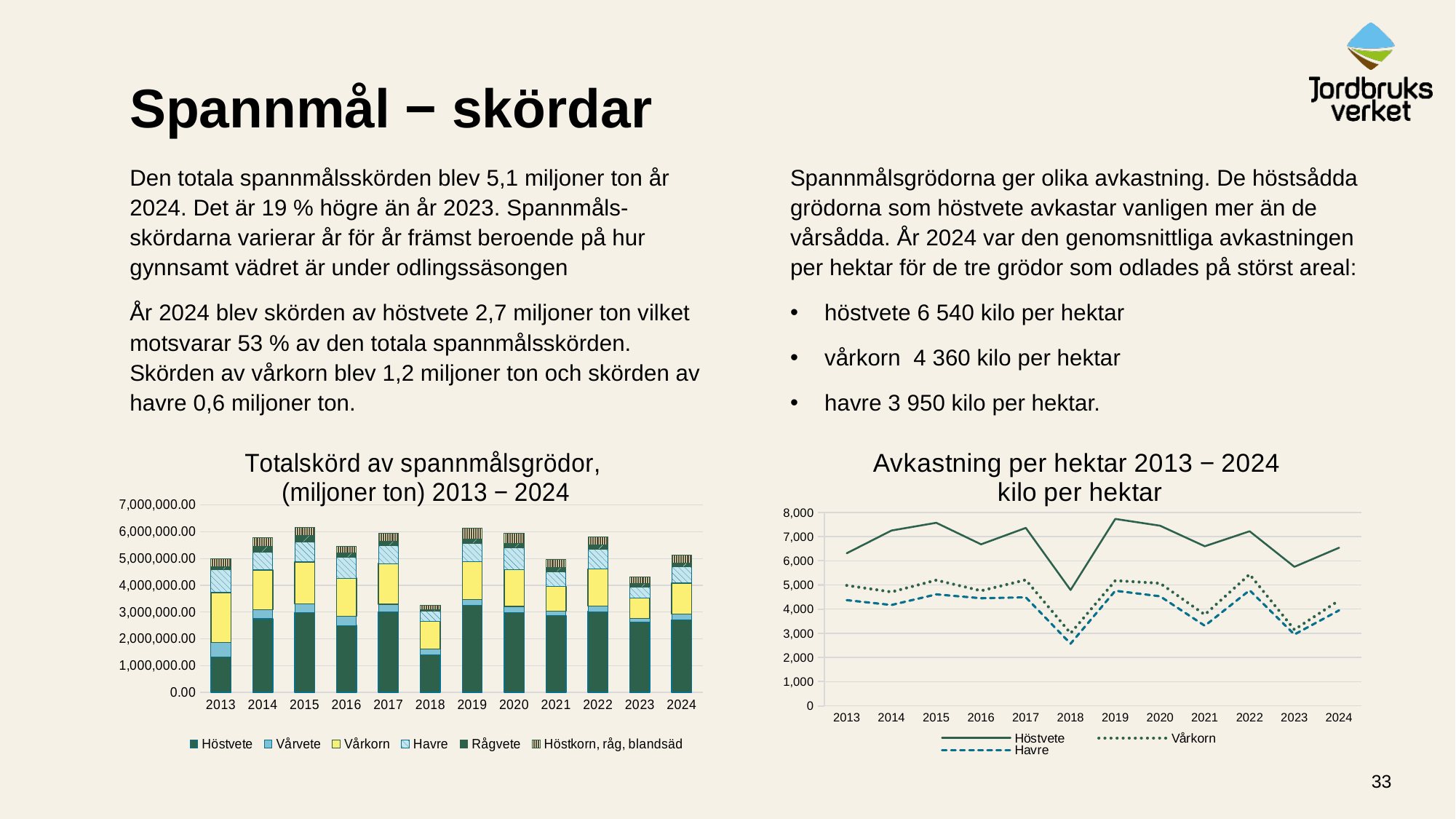
What kind of chart is the right chart titled 'Avkastning per hektar 2013 − 2024'? Line chart In the left chart 'Totalskörd av spannmålsgrödor', which year has the lowest total harvest? 2018 In the right chart 'Avkastning per hektar', which year has the lowest value for Höstvete? 2018 In the right chart 'Avkastning per hektar', how many series does the legend list? 3 How many years are shown on the x axis of the left chart 'Totalskörd av spannmålsgrödor'? 12 In the right chart 'Avkastning per hektar', which is larger in 2024: Höstvete or Havre? Höstvete In the right chart 'Avkastning per hektar', does the Höstvete line rise or fall from 2022 to 2023? Fall What kind of chart is the left chart titled 'Totalskörd av spannmålsgrödor'? Stacked bar chart In the right chart 'Avkastning per hektar', is the value for Havre in 2018 greater or less than 3,000? less In the left chart 'Totalskörd av spannmålsgrödor', how many series does the legend list? 6 In the left chart 'Totalskörd av spannmålsgrödor', is the total for 2018 greater or less than 4,000,000.00? less In the left chart 'Totalskörd av spannmålsgrödor', is the total for 2023 greater or less than 5,000,000.00? less